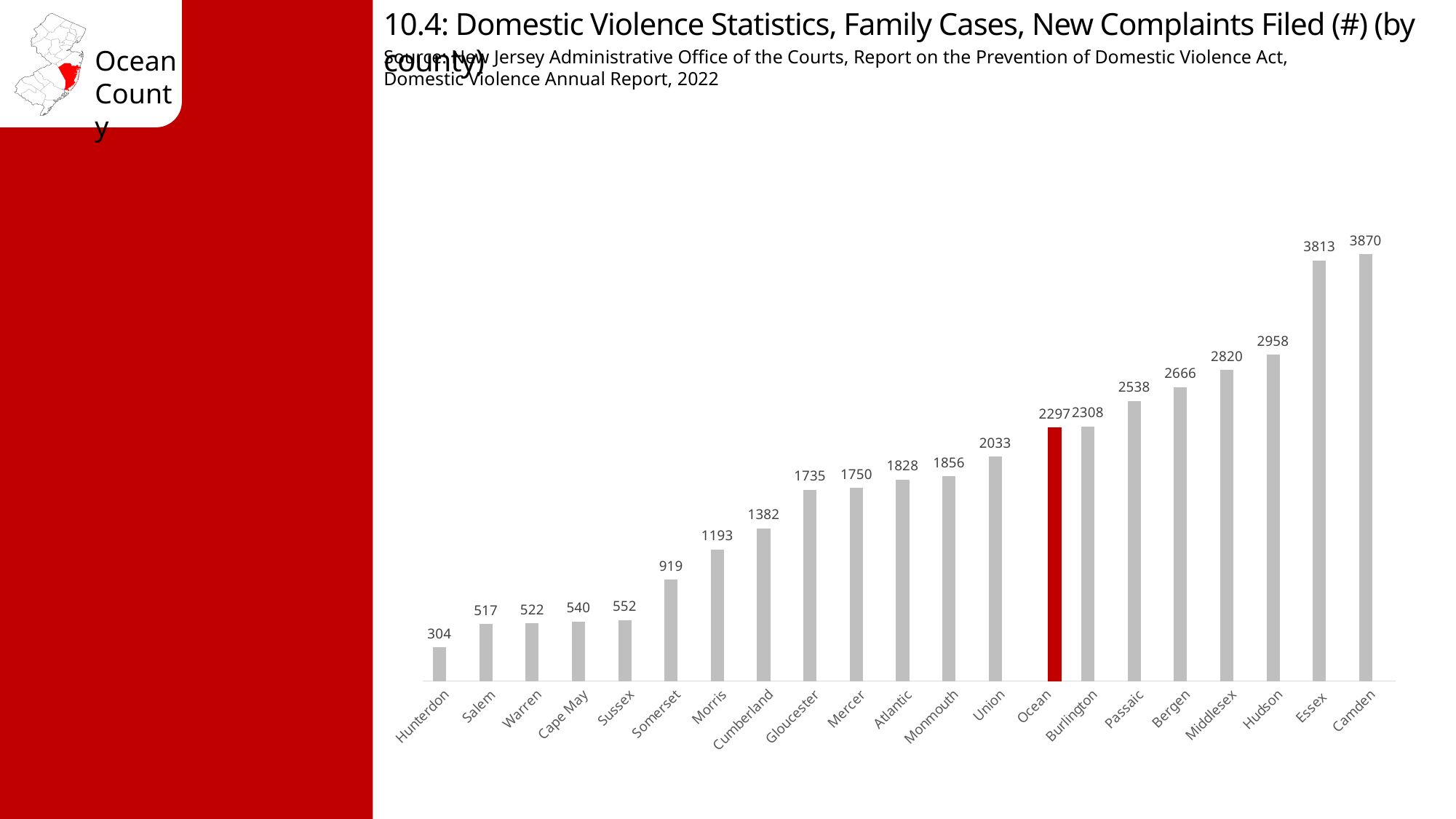
Do the values rise or fall moving from left to right along the x axis? Rise What is the difference between the values for Ocean and Hunterdon? 1993 Which county has the lowest number of new complaints filed? Hunterdon How many counties are shown on the chart? 21 What is the difference between the values for Camden and Essex? 57 Which has a larger value, Passaic or Monmouth? Passaic Which has a larger value, Union or Morris? Union What kind of chart is shown on the slide? Bar chart What is the value shown for Hudson? 2958 How many new domestic violence complaints were filed in family cases in Ocean County? 2297 Which county has the highest number of new complaints filed? Camden What is the value shown for Somerset? 919